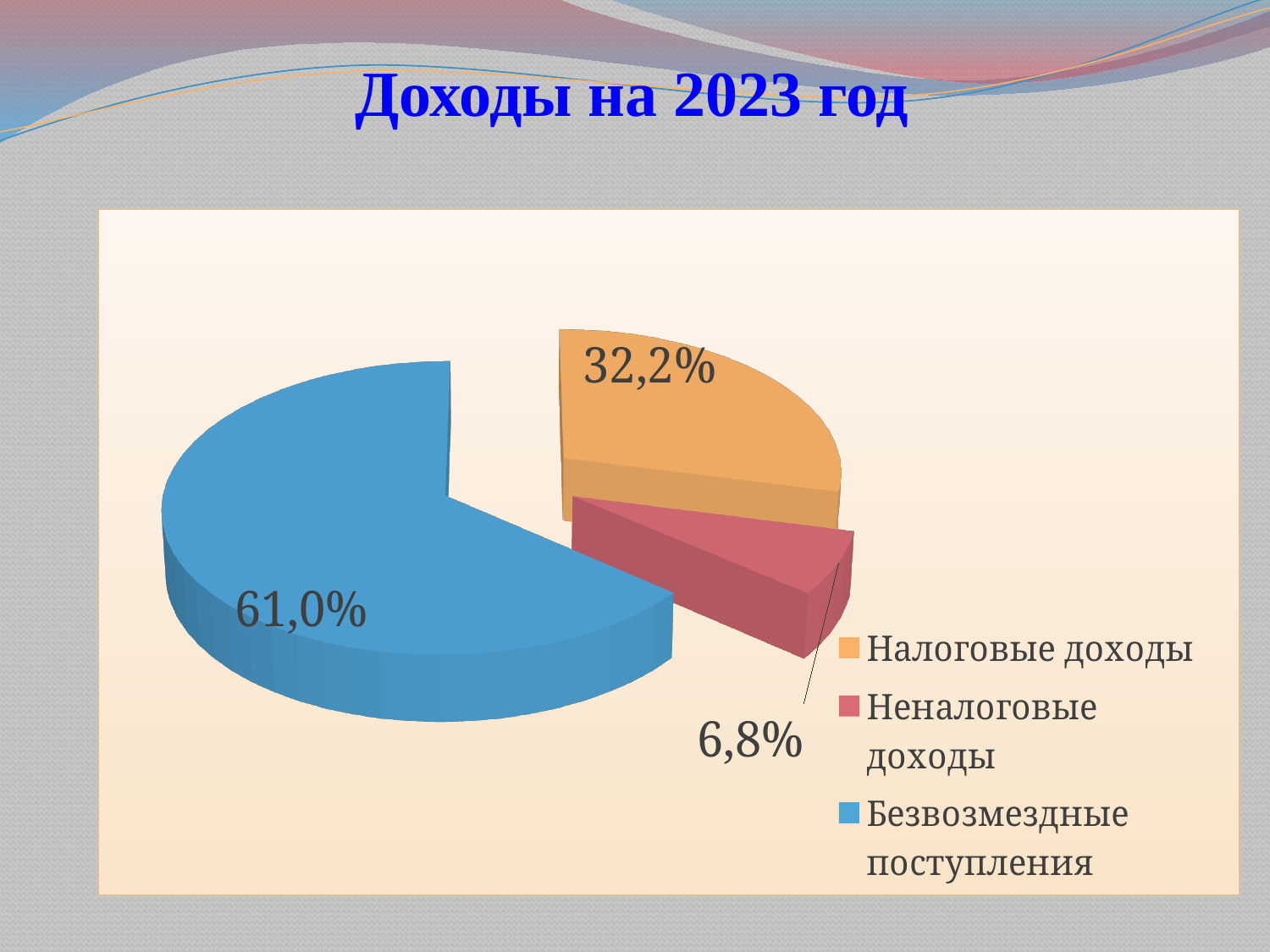
What share of the pie does Неналоговые доходы represent? 6,8% What kind of chart is shown on the slide? Pie chart What colour is the slice for Безвозмездные поступления? Blue What is the difference in percentage points between Безвозмездные поступления and Налоговые доходы? 28,8 What is the difference in percentage points between Налоговые доходы and Неналоговые доходы? 25,4 How many slices does the pie chart have? 3 What share of the pie does Безвозмездные поступления represent? 61,0% What share of the pie does Налоговые доходы represent? 32,2% Which is larger: the share for Налоговые доходы or the share for Неналоговые доходы? Налоговые доходы Which category has the smallest share of the pie? Неналоговые доходы What is the title of the slide? Доходы на 2023 год Which category has the largest share of the pie? Безвозмездные поступления